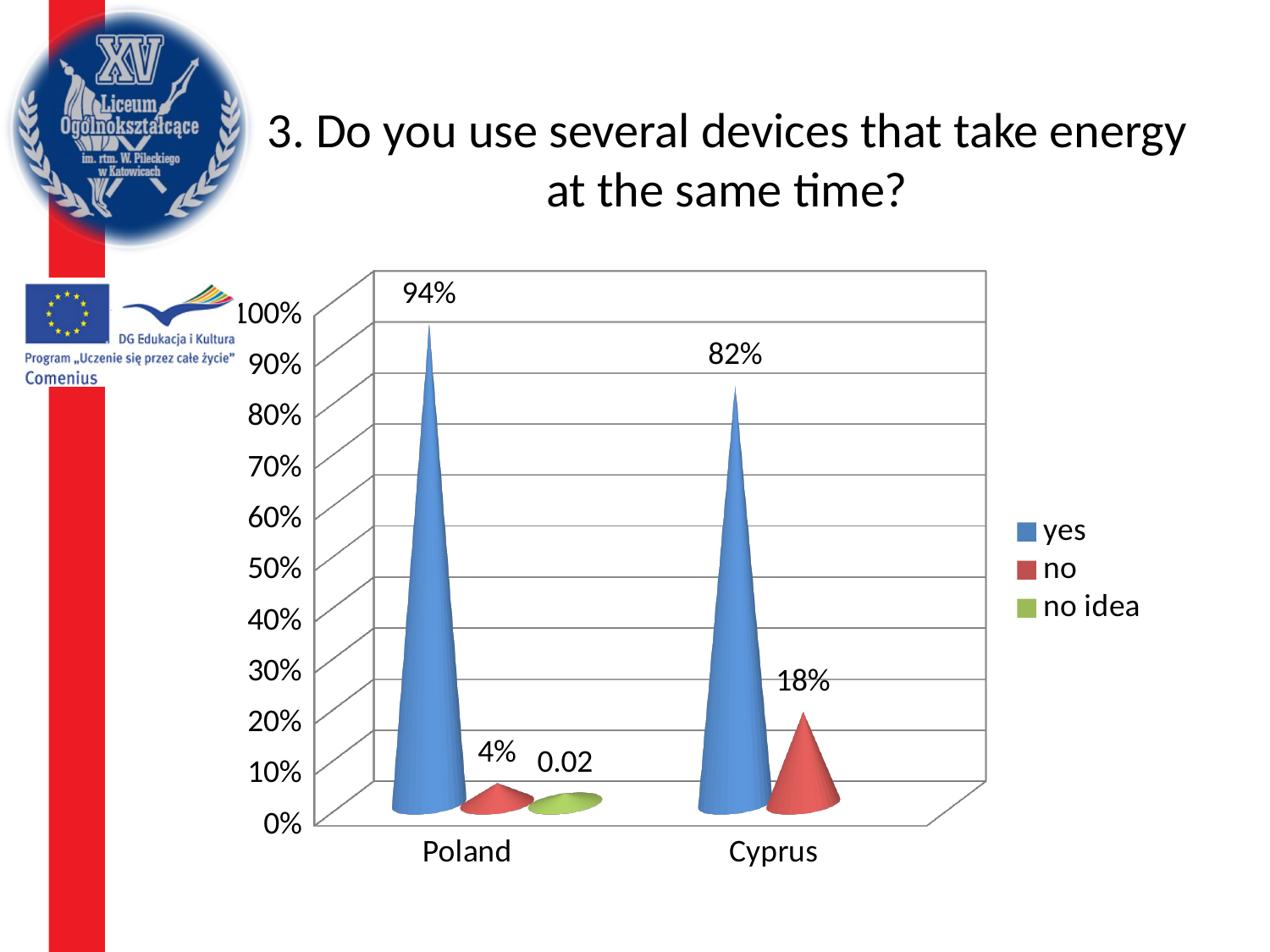
Which country has the higher "yes" value? Poland What is the difference between the "no" values for Cyprus and Poland? 14% What is the value labelled for "no" in Cyprus? 18% What colour represents the "no idea" series in the legend? Green What is the value labelled for "no idea" in Poland? 0.02 What percentage of respondents in Cyprus answered "yes"? 82% What percentage of respondents in Poland answered "yes"? 94% How many series does the legend list? 3 What is the value labelled for "no" in Poland? 4% Which country has the higher "no" value? Cyprus What is the difference between the "yes" values for Poland and Cyprus? 12% How many countries are shown on the x axis? 2